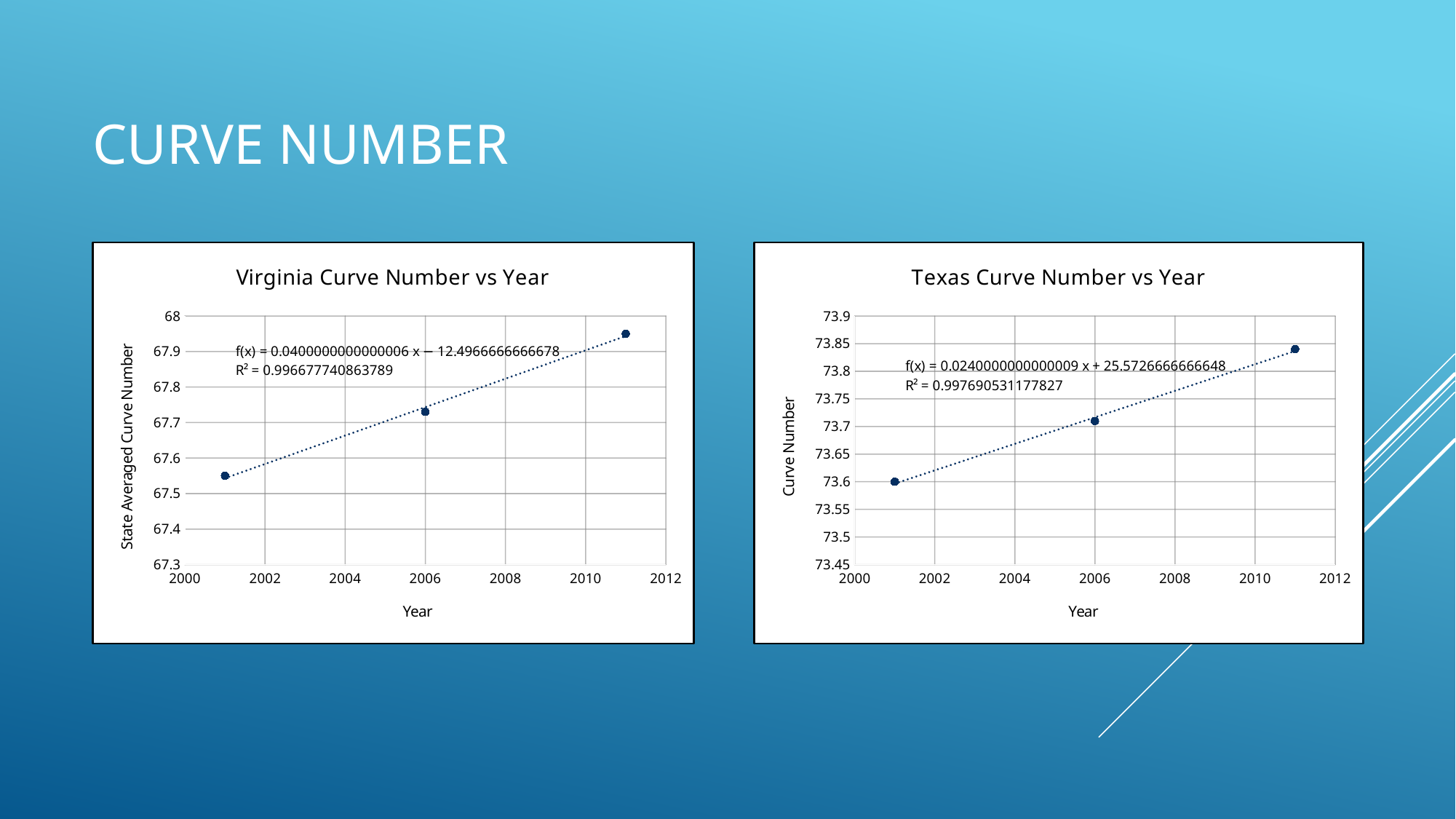
In the Texas Curve Number vs Year chart, is the value for 2011 greater or less than 73.8? greater In the Virginia Curve Number vs Year chart, which year has the highest curve number? 2011 How many data points are plotted in the Texas Curve Number vs Year chart? 3 In the Virginia Curve Number vs Year chart, do the values rise or fall as the year increases? rise What is the y-axis label of the Virginia Curve Number vs Year chart? State Averaged Curve Number What R² value is shown on the Texas Curve Number vs Year chart? 0.997690531177827 In the Virginia Curve Number vs Year chart, is the value for 2006 greater or less than 67.8? less In the Texas Curve Number vs Year chart, which year has the lowest curve number? 2001 In the Texas Curve Number vs Year chart, do the values rise or fall as the year increases? rise How many data points are plotted in the Virginia Curve Number vs Year chart? 3 In the Virginia Curve Number vs Year chart, which is larger, the value for 2001 or the value for 2011? 2011 What kind of chart is the Virginia Curve Number vs Year chart? scatter chart